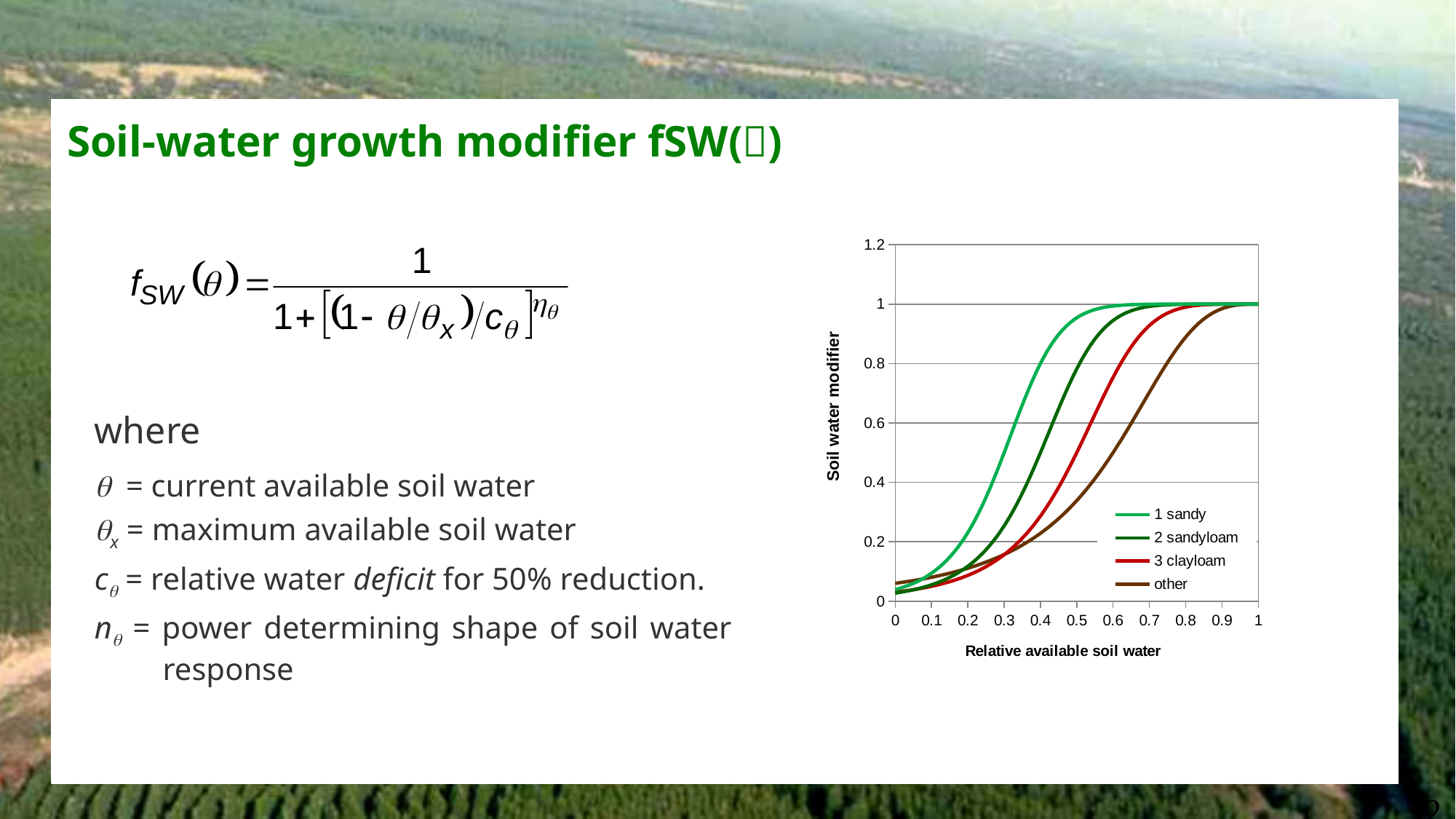
What is the title of the chart's x axis? Relative available soil water Do the curves rise or fall as relative available soil water increases from 0 to 1? rise At a relative available soil water of 0.7, is the value for the '3 clayloam' series greater or less than 0.8? greater How many series does the chart legend list? 4 At a relative available soil water of 0.3, which series has the highest soil water modifier? 1 sandy At a relative available soil water of 0.5, is the value for the 'other' series greater or less than 0.4? less At a relative available soil water of 0.5, is the value for the '1 sandy' series greater or less than 0.8? greater What kind of chart is shown on the slide? line chart At a relative available soil water of 0.5, which series has the lowest soil water modifier? other What is the title of the chart's y axis? Soil water modifier At a relative available soil water of 0.4, which series has the higher soil water modifier, '1 sandy' or 'other'? 1 sandy